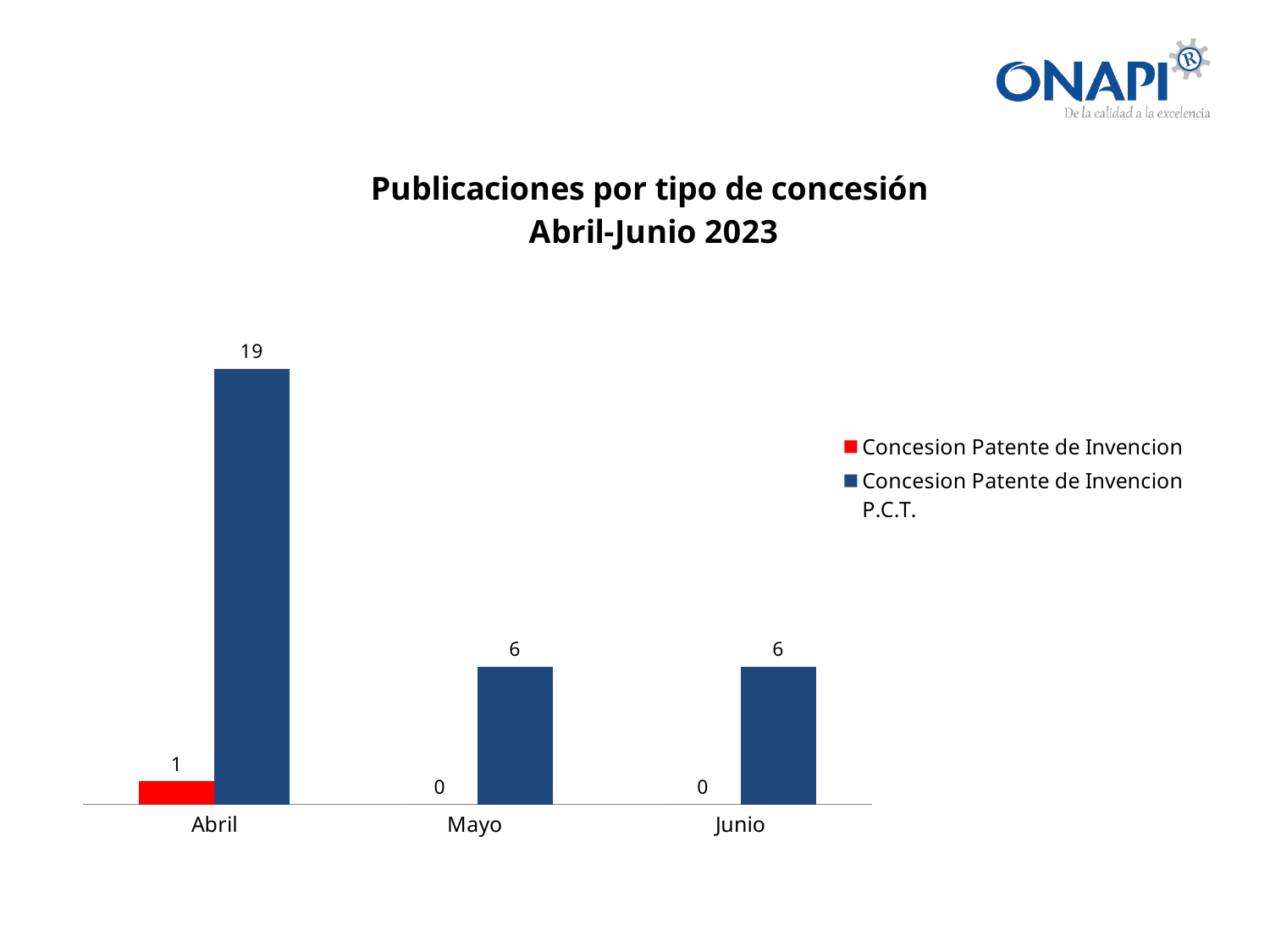
What is the value for Concesion Patente de Invencion P.C.T. in Abril? 19 What kind of chart is shown on the slide? Bar chart What is the value for Concesion Patente de Invencion P.C.T. in Mayo? 6 Does the value for Concesion Patente de Invencion P.C.T. rise or fall from Abril to Mayo? Fall What is the difference between the Concesion Patente de Invencion P.C.T. values for Abril and Mayo? 13 How many series does the legend list? 2 Which month has the highest value for Concesion Patente de Invencion P.C.T.? Abril Which is larger in Abril: Concesion Patente de Invencion or Concesion Patente de Invencion P.C.T.? Concesion Patente de Invencion P.C.T. What is the value for Concesion Patente de Invencion in Junio? 0 What is the value for Concesion Patente de Invencion in Abril? 1 What is the title of the chart? Publicaciones por tipo de concesión Abril-Junio 2023 How many months are shown on the x axis? 3